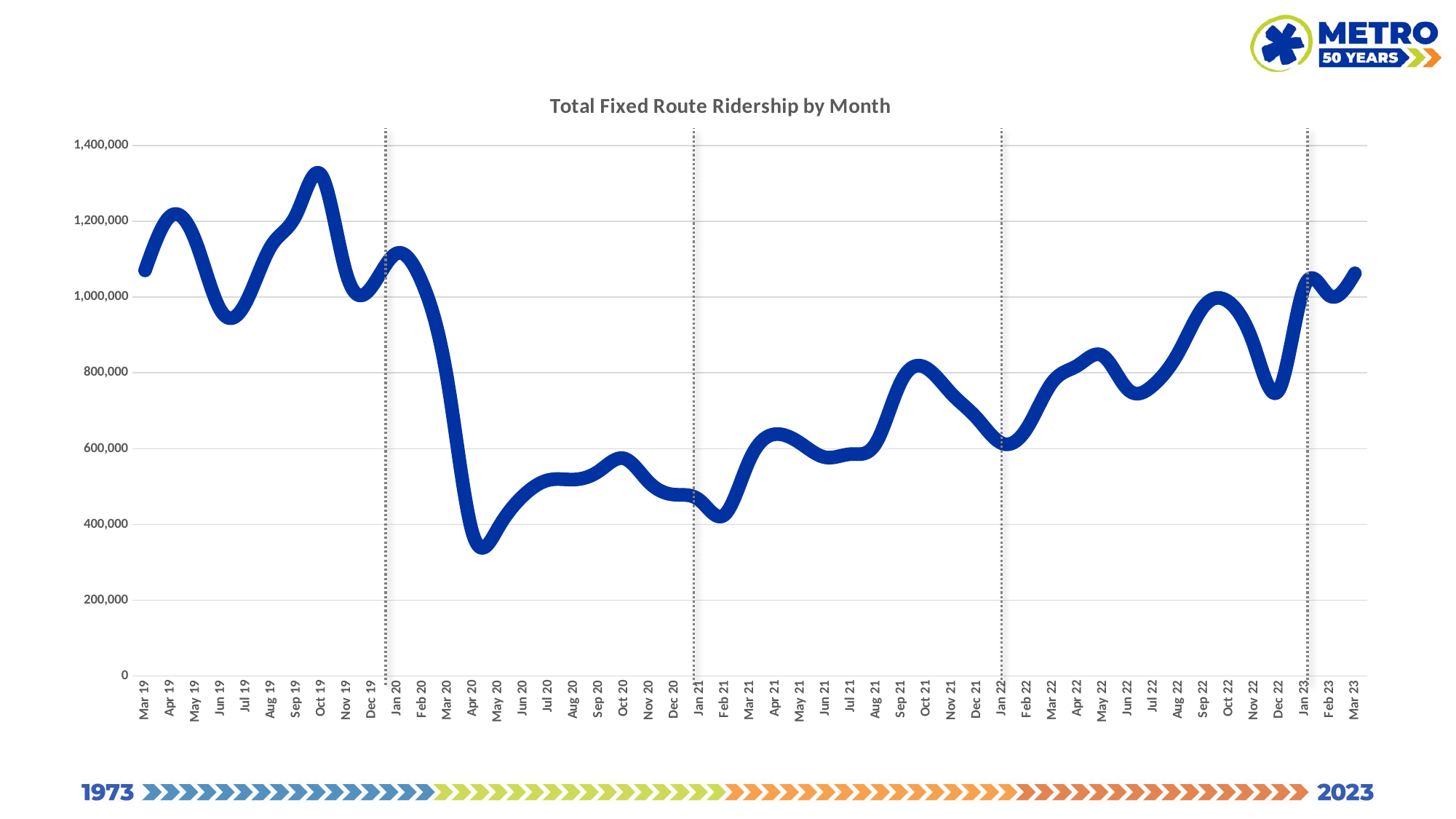
How many monthly data points are plotted on the chart? 49 Is the value for Feb 21 greater or less than 600,000? less What kind of chart is shown on the slide? line chart How many vertical dotted lines mark the January boundaries on the chart? 4 Is the value for Apr 20 greater or less than 400,000? less Does ridership rise or fall from Mar 20 to Apr 20? fall Is the value for Oct 19 greater or less than 1,200,000? greater Which month has the highest ridership on the chart? Oct 19 Which is larger, the ridership for Oct 19 or for Apr 20? Oct 19 Which month has the lowest ridership on the chart? Apr 20 What is the title of the chart? Total Fixed Route Ridership by Month